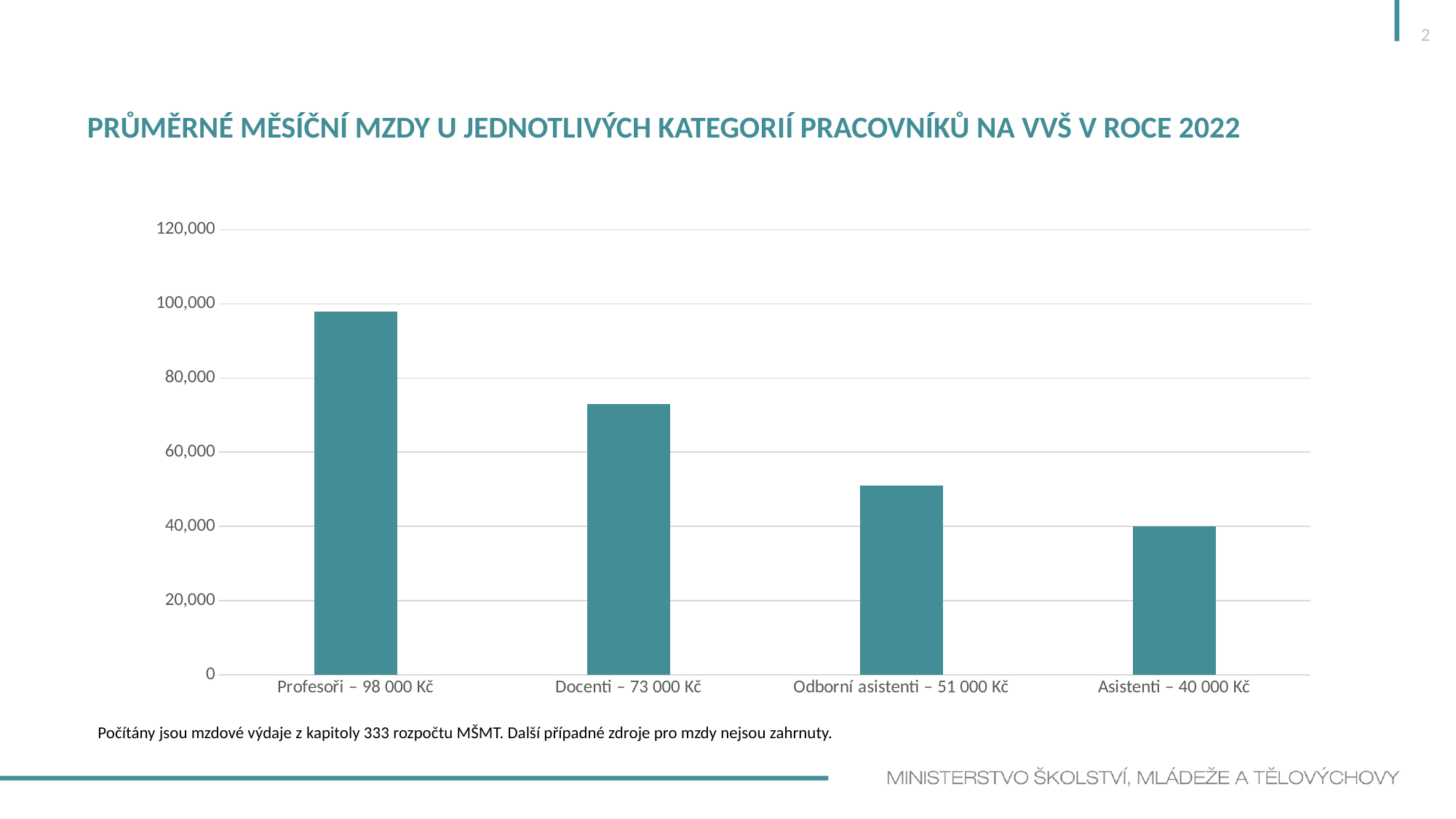
How many categories of workers are shown in the chart? 4 Is the value for Docenti greater or less than 80,000? less What is the average monthly salary for Profesoři? 98 000 Kč What is the average monthly salary for Odborní asistenti? 51 000 Kč What is the average monthly salary for Docenti? 73 000 Kč Which category has the lowest average monthly salary? Asistenti What is the average monthly salary for Asistenti? 40 000 Kč What is the difference between the average monthly salary of Odborní asistenti and Asistenti? 11 000 Kč What is the difference between the average monthly salary of Profesoři and Docenti? 25 000 Kč What kind of chart is shown on the slide? Bar chart Which category has the highest average monthly salary? Profesoři Which is larger, the average monthly salary of Docenti or of Odborní asistenti? Docenti